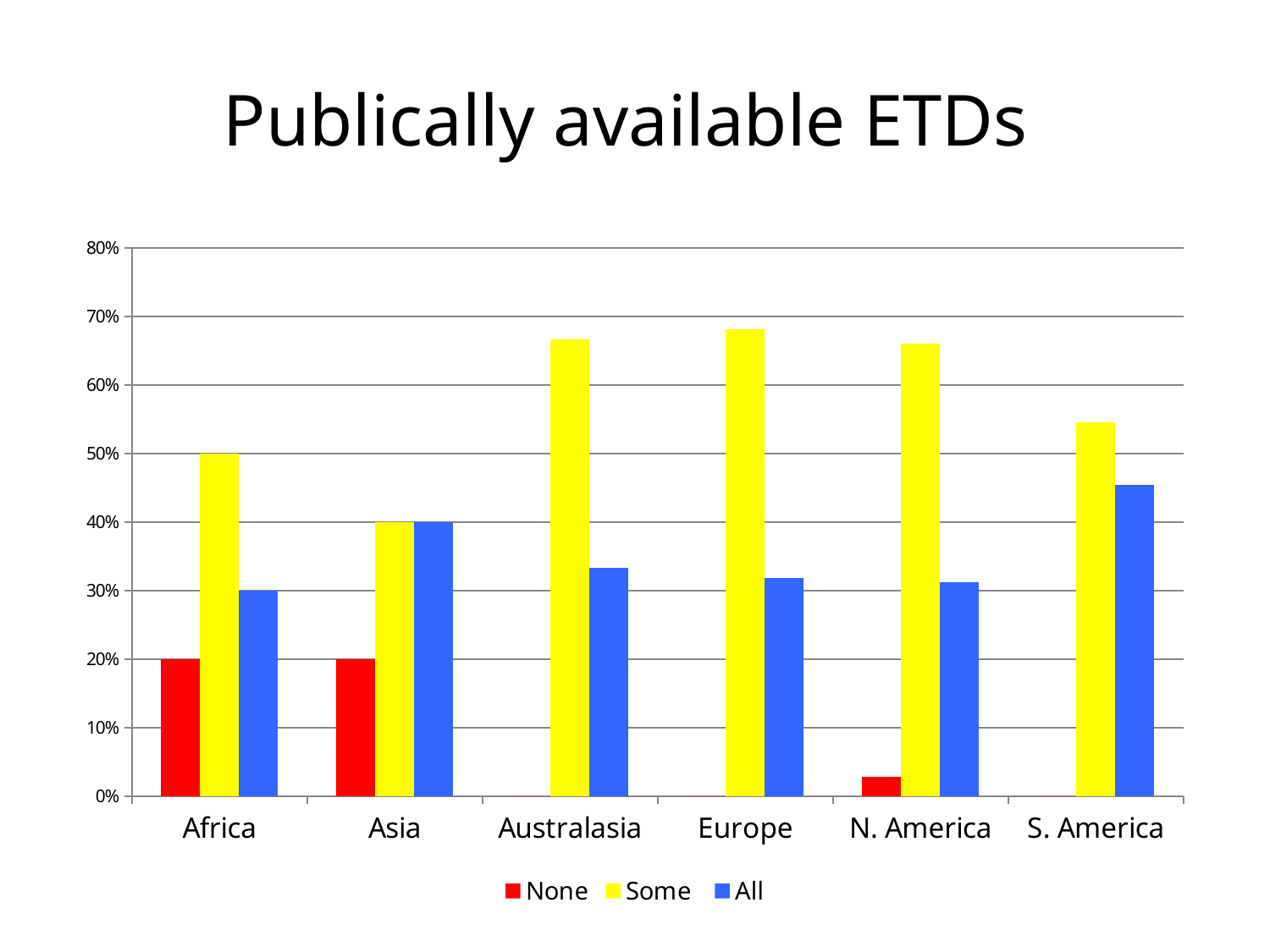
What is the difference between the 'Some' and 'All' values for Africa? 20% What is the title of the chart? Publically available ETDs Which is larger, the 'All' value for Asia or the 'All' value for Europe? Asia What type of chart is shown on the slide? bar chart What is the value for 'All' in Africa? 30% Which region has the highest 'All' value? S. America How many series does the legend list? 3 How many regions are shown on the x axis? 6 Is the 'Some' value for Australasia greater or less than 60%? greater Which region has the highest 'Some' value? Europe What is the value for 'Some' in Africa? 50% What is the value for 'None' in Asia? 20%